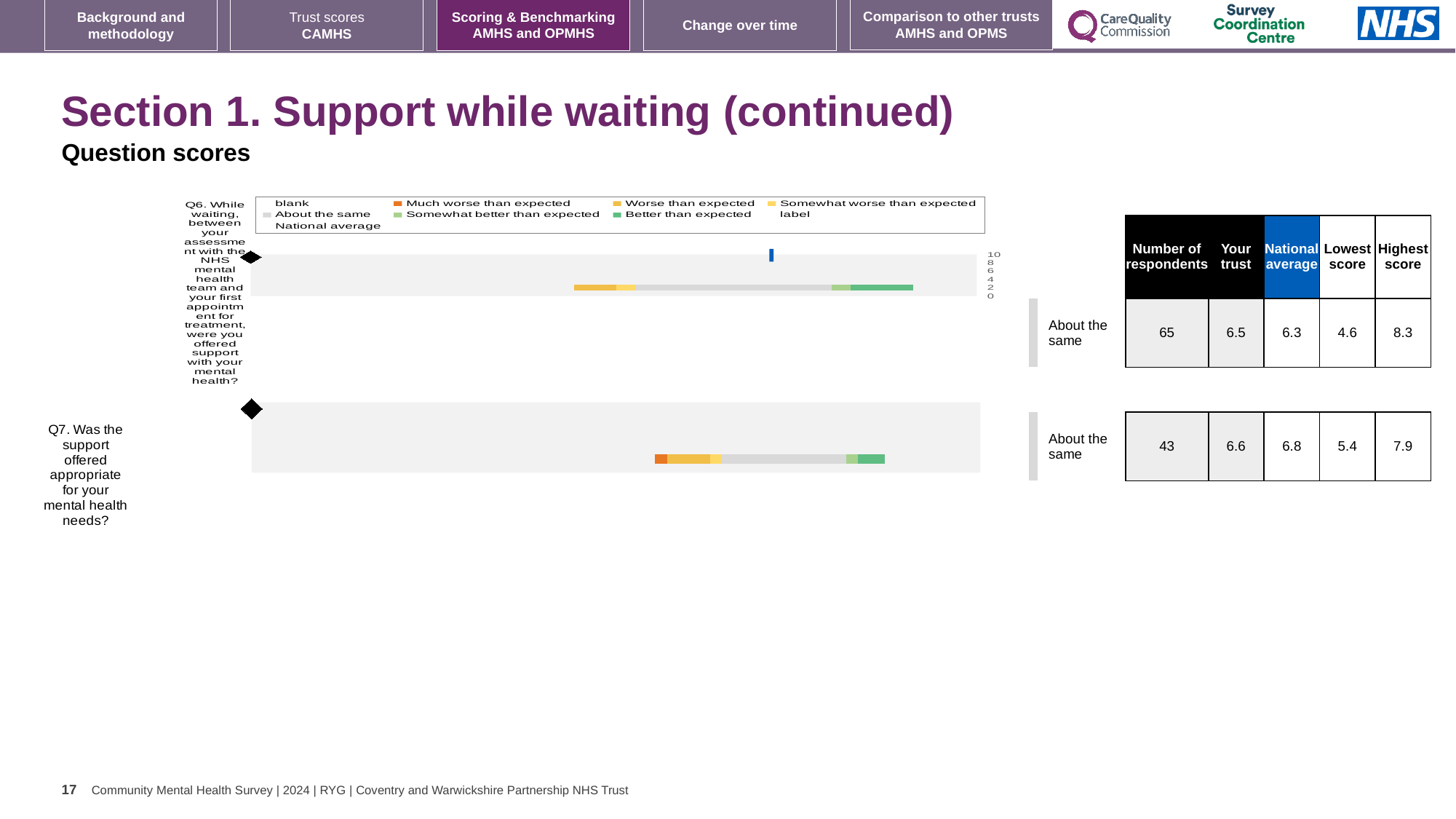
What is the 'Your trust' score for Q7? 6.6 What is the difference between the highest score and the lowest score for Q7? 2.5 What is the lowest score for Q6? 4.6 For Q6, which is larger: the 'Your trust' score or the national average? Your trust How many questions are plotted in the chart? 2 What kind of chart is used to show the question scores for Q6 and Q7? bar chart What is the difference between the highest score and the lowest score for Q6? 3.7 What benchmark category is shown next to the Q7 bar? About the same What is the national average score for Q6? 6.3 What is the number of respondents for Q6? 65 What is the highest score for Q7? 7.9 Which question has more respondents, Q6 or Q7? Q6